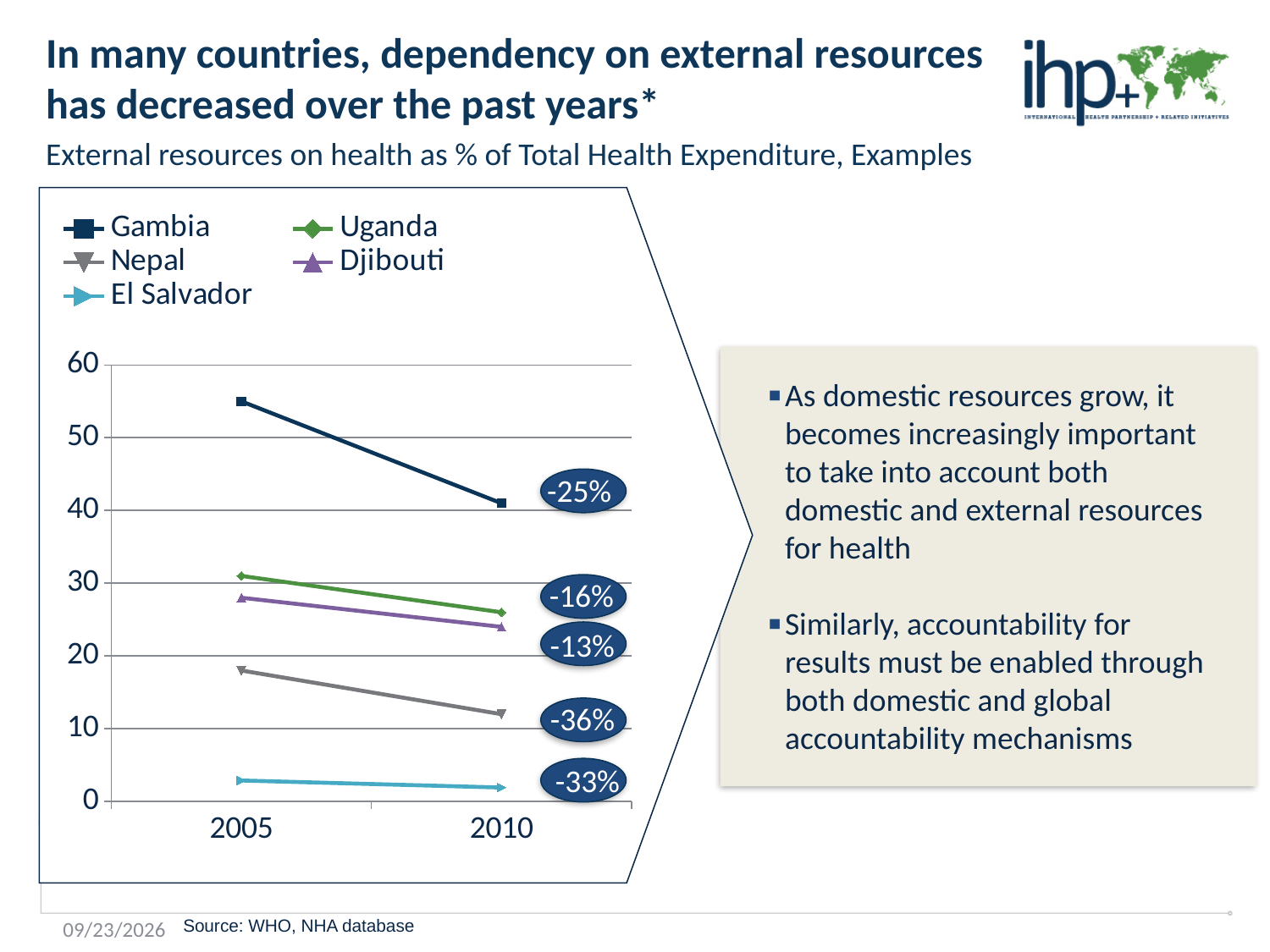
Is the value for Gambia in 2005 greater or less than 50? greater What percentage change is labelled for Nepal on the chart? -36% How many years are shown on the x axis of the chart? 2 Which country has the lowest value in 2010? El Salvador How many series does the chart legend list? 5 What is the subtitle describing what the chart measures? External resources on health as % of Total Health Expenditure, Examples What kind of chart is shown on the slide? line chart Which country has the highest value in 2005? Gambia Which is larger in 2005, the value for Uganda or the value for Nepal? Uganda Does the value for Gambia rise or fall from 2005 to 2010? fall What percentage change is labelled for Gambia on the chart? -25% Is the value for Nepal in 2010 greater or less than 20? less